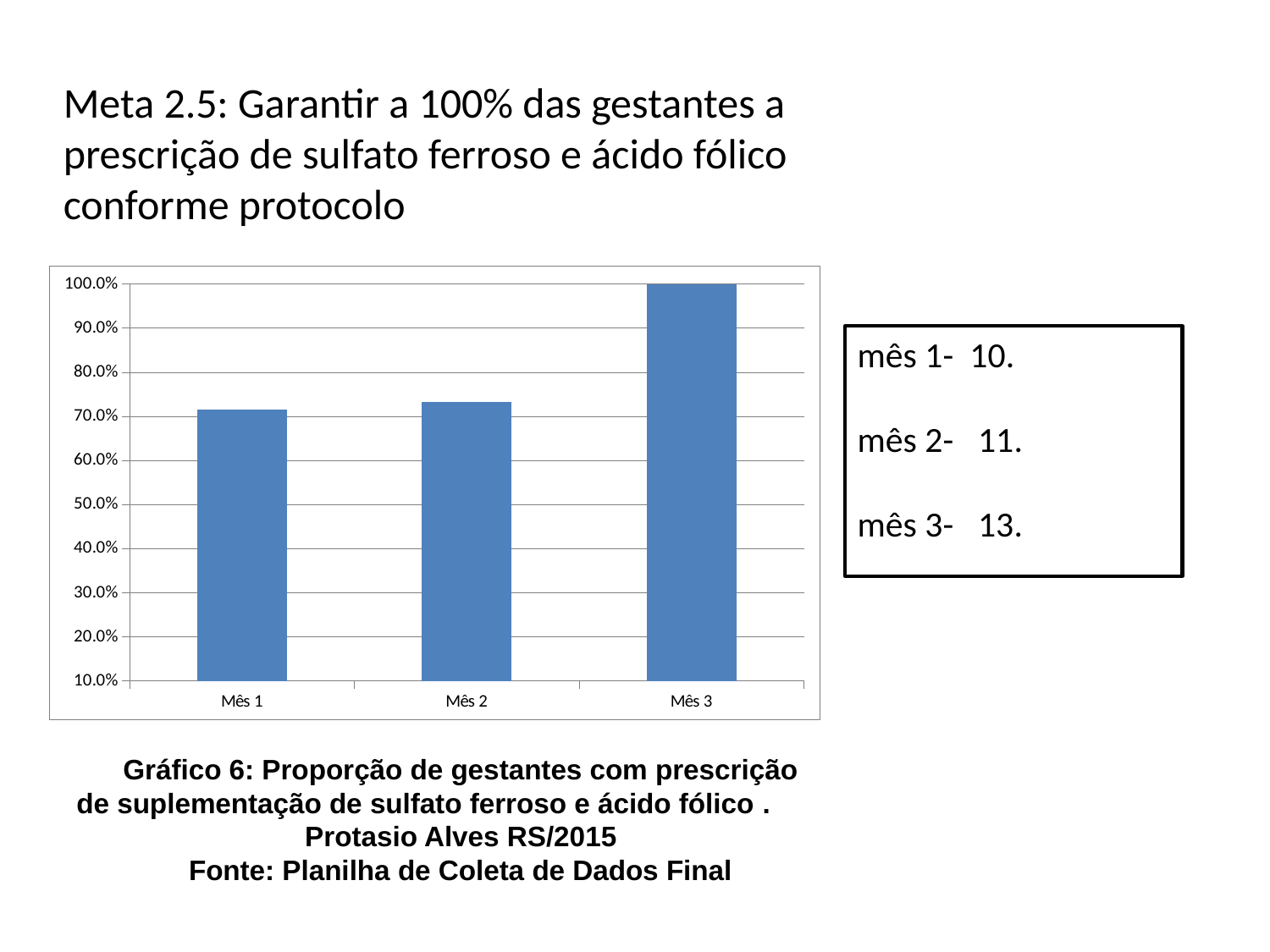
What is the value for Mês 3 on the chart? 100.0% What is the label of the first category on the x axis? Mês 1 Do the values rise or fall from Mês 1 to Mês 3? rise Which is larger, the value for Mês 1 or the value for Mês 3? Mês 3 Is the value for Mês 2 greater or less than 60.0%? greater What kind of chart is shown on the slide? bar chart Is the value for Mês 1 greater or less than 80.0%? less Is the value for Mês 2 greater or less than 80.0%? less What is the lowest value shown on the chart's vertical axis? 10.0% How many categories (months) are plotted on the chart? 3 Which month has the highest value on the chart? Mês 3